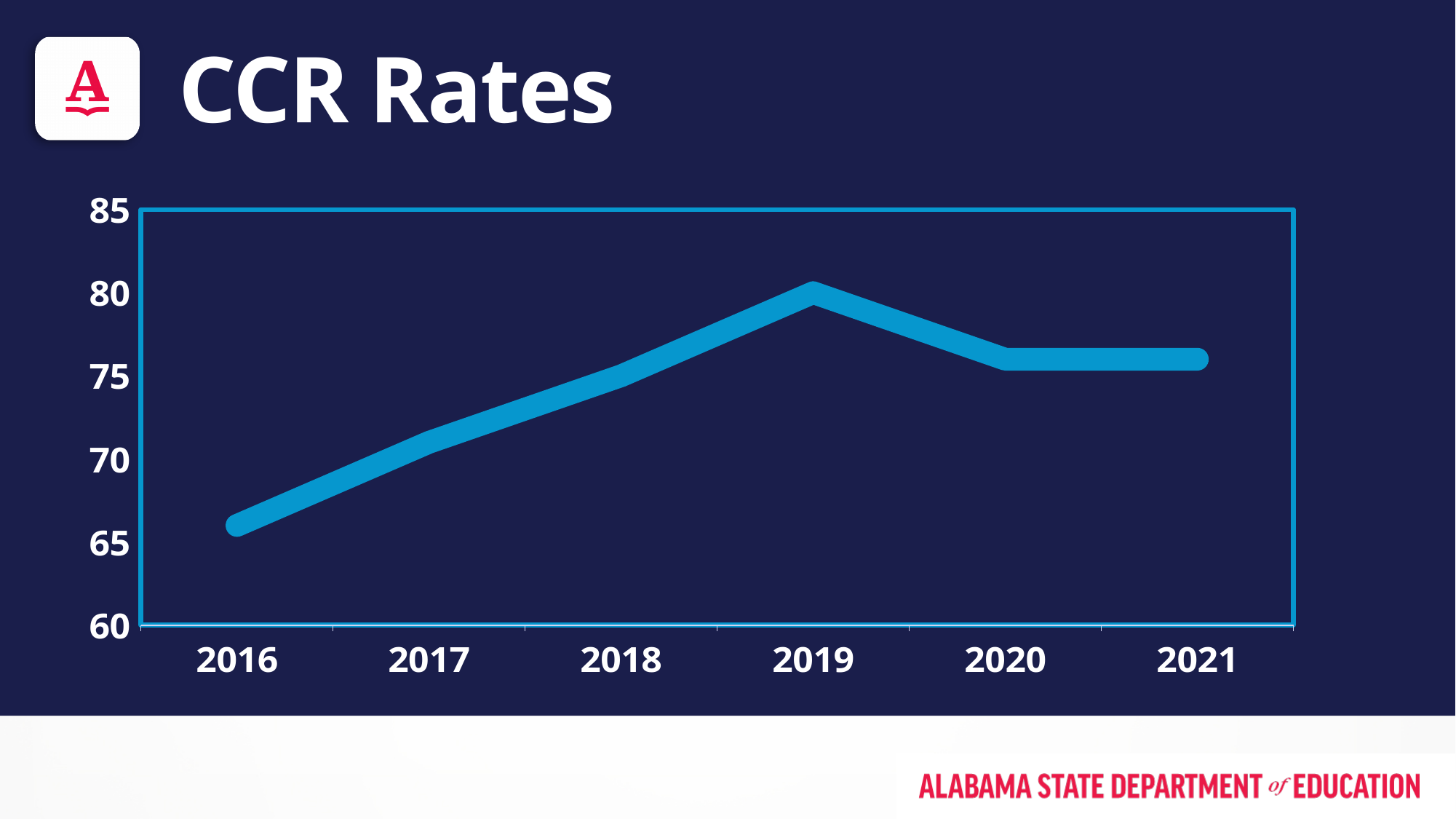
Is the value for 2021 greater or less than 80? less What kind of chart is shown on the slide? line chart Which is larger, the value for 2019 or the value for 2016? 2019 Which year has the lowest CCR rate? 2016 What is the title of the chart? CCR Rates Which year has the highest CCR rate? 2019 Is the value for 2019 greater or less than 75? greater Is the value for 2017 greater or less than 75? less Do the values rise or fall from 2016 to 2019? rise How many years are plotted on the x axis? 6